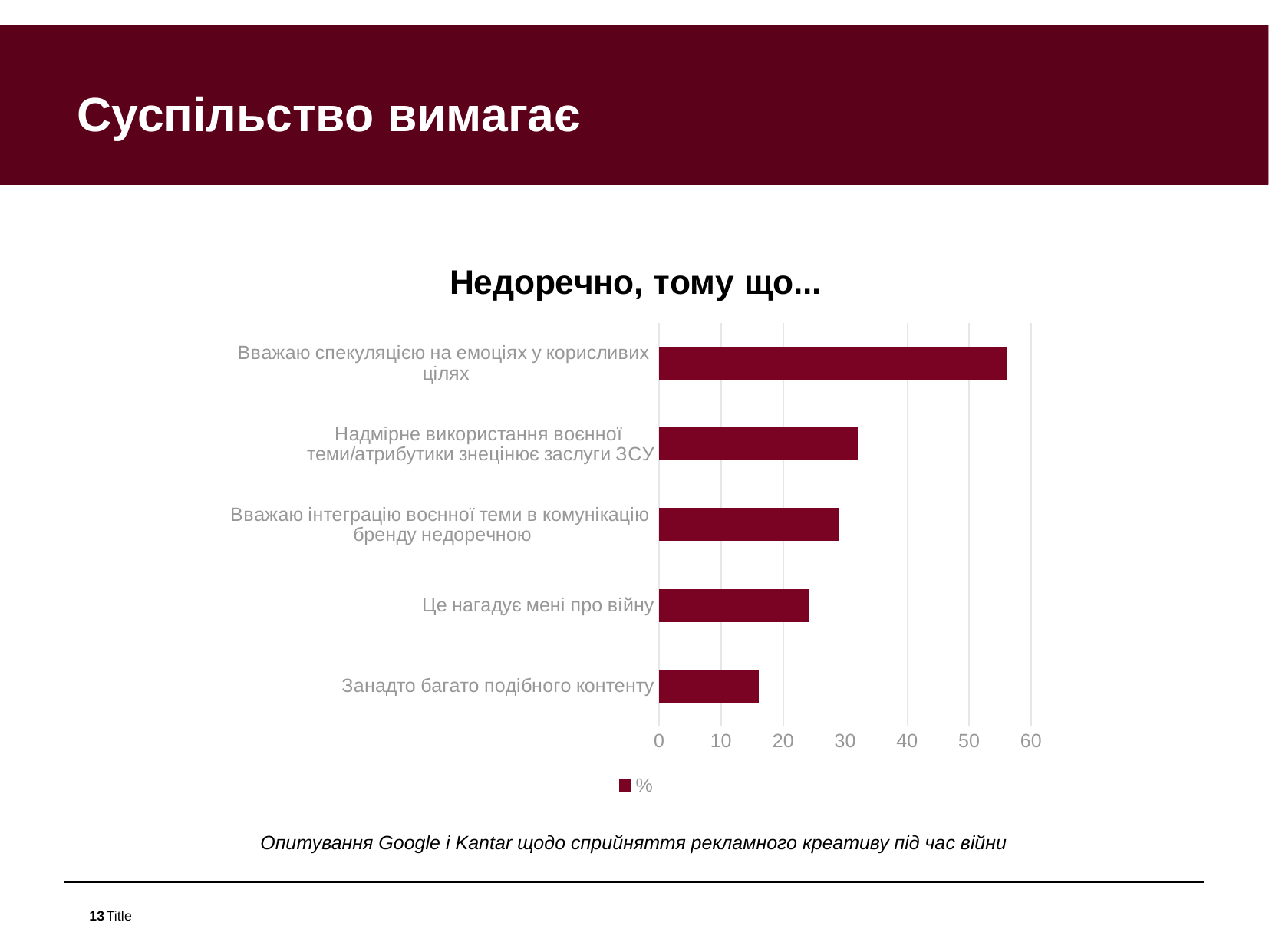
Is the value for 'Занадто багато подібного контенту' greater or less than 20? less What is the legend entry for the series? % Which category has the highest value? Вважаю спекуляцією на емоціях у корисливих цілях How many categories are plotted in the chart? 5 How many series does the legend list? 1 Which is larger: the value for 'Це нагадує мені про війну' or the value for 'Занадто багато подібного контенту'? Це нагадує мені про війну Is the value for 'Вважаю спекуляцією на емоціях у корисливих цілях' greater or less than 50? greater What is the title of the chart? Недоречно, тому що... What kind of chart is shown on the slide? bar chart Is the value for 'Надмірне використання воєнної теми/атрибутики знецінює заслуги ЗСУ' greater or less than 40? less Which category has the lowest value? Занадто багато подібного контенту